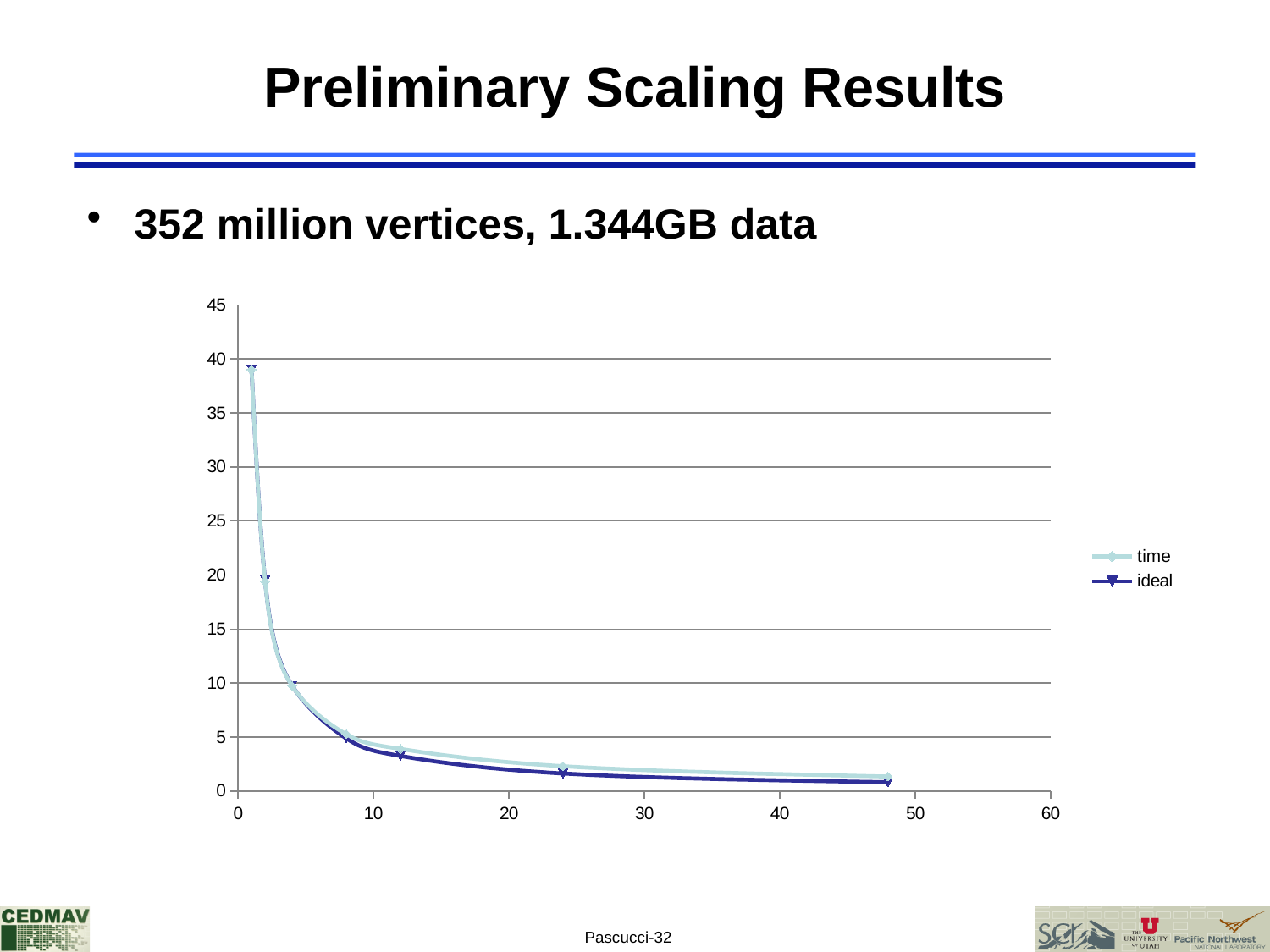
Is the value of the ideal series at x = 2 greater or less than 15? greater At x = 24, which series has the larger value, time or ideal? time Is the value of the time series at x = 24 greater or less than 5? less Is the value of the time series at x = 48 greater or less than 5? less What is the highest value shown on the y axis? 45 How many series does the legend list? 2 What kind of chart is shown on the slide? line chart Do the values of the time series rise or fall as the x axis increases? fall Do the values of the ideal series rise or fall as the x axis increases? fall What are the two series named in the legend? time and ideal